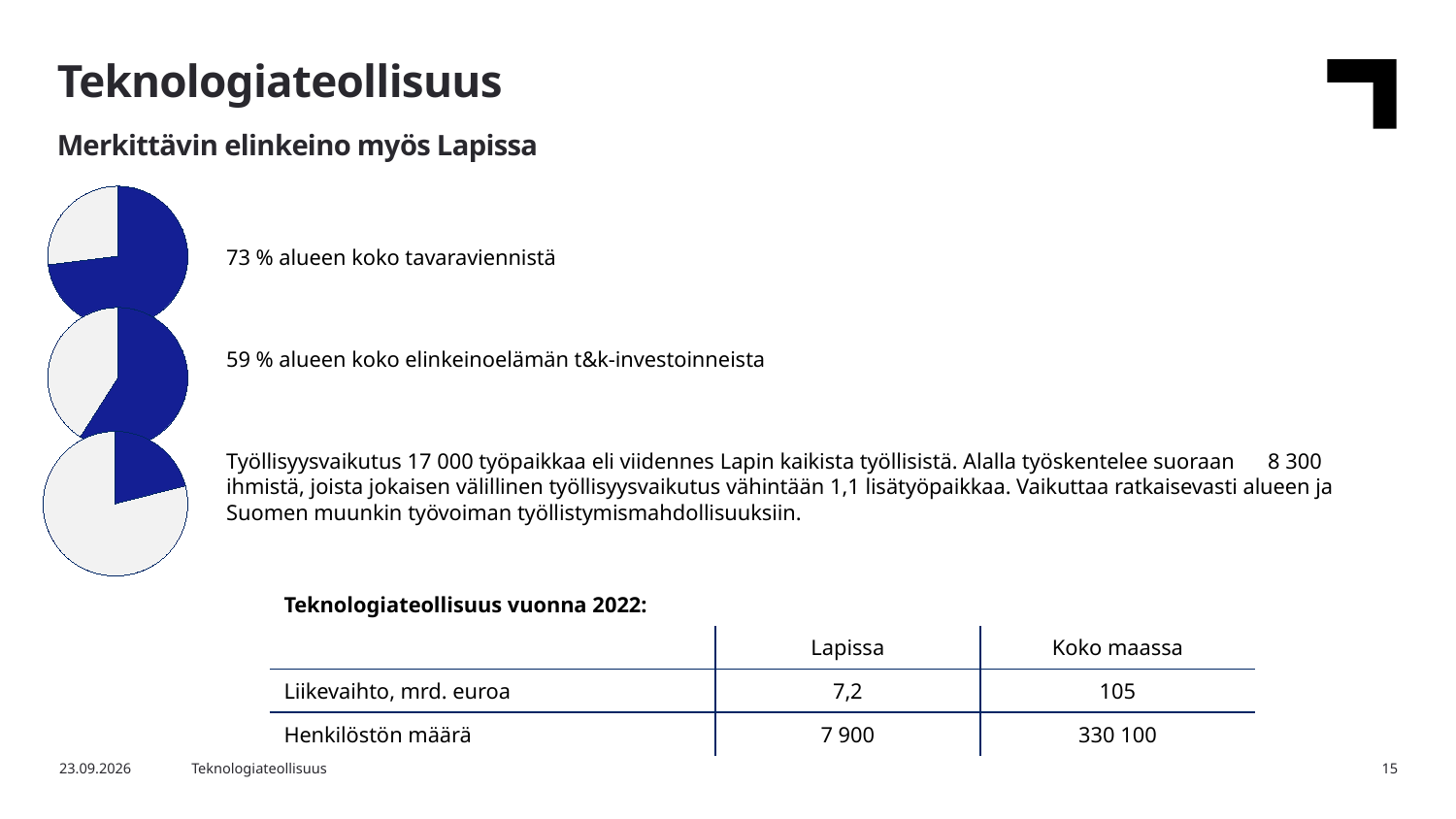
How many slices does each pie chart have? 2 What kind of charts are shown on the left side of the slide? Pie charts Is the highlighted share in the top pie chart (73 %) larger or smaller than the highlighted share in the middle pie chart (59 %)? Larger Which pie chart has the largest highlighted (blue) slice: the top, middle or bottom one? Top According to the text next to the middle pie chart, what share of the region's business R&D investments does the technology industry account for? 59 % How many pie charts are on the slide? 3 Does the highlighted slice in the bottom pie chart cover more or less than half of the pie? Less Which pie chart has the smallest highlighted (blue) slice: the top, middle or bottom one? Bottom According to the text next to the top pie chart, what share of the region's total goods exports does the technology industry account for? 73 % What is the difference in percentage points between the share shown for the top pie chart (73 %) and the middle pie chart (59 %)? 14 percentage points What colour is used for the highlighted slice in the pie charts? Dark blue